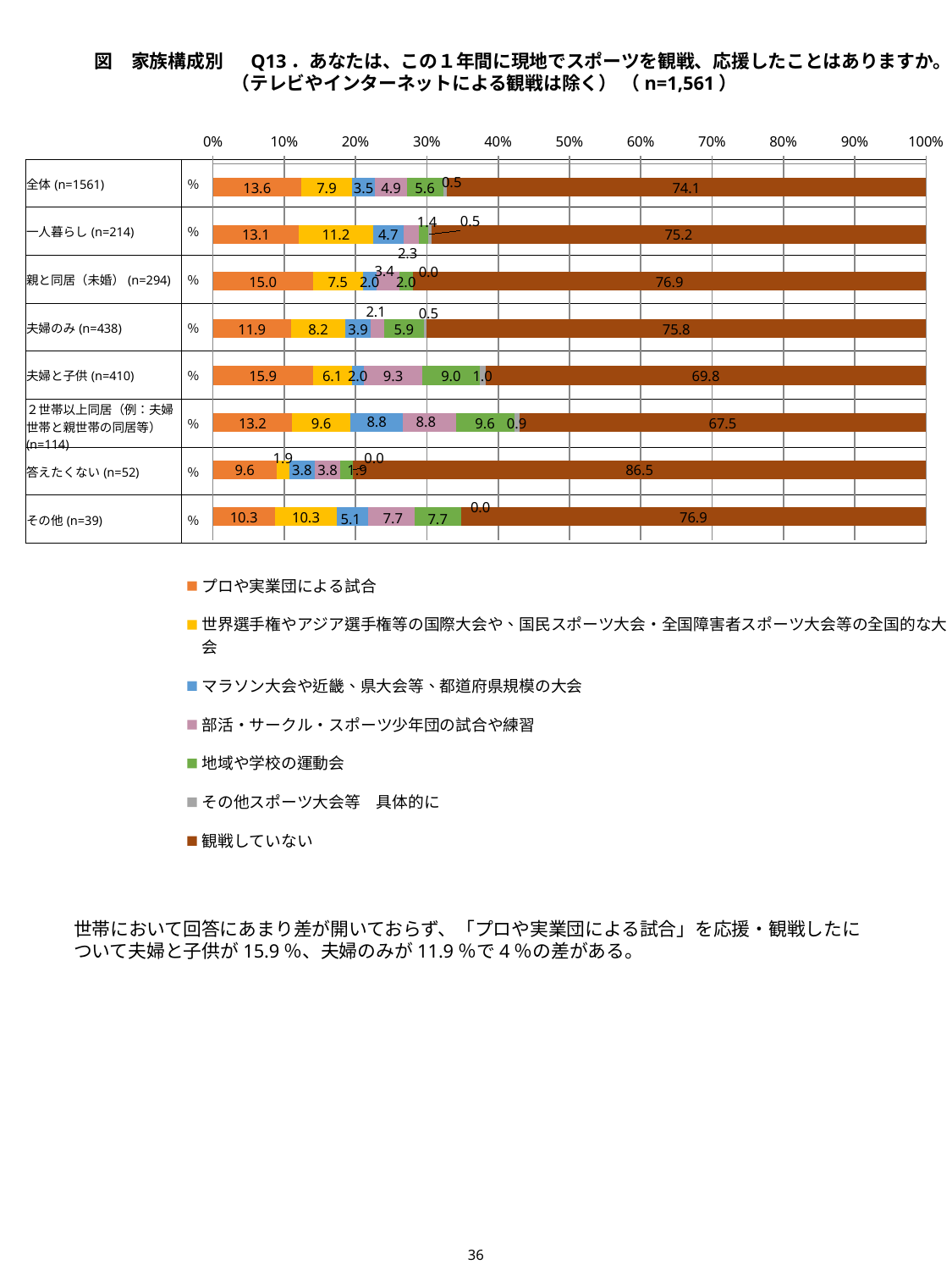
What is the value for 世界選手権やアジア選手権等の国際大会や、国民スポーツ大会・全国障害者スポーツ大会等の全国的な大会 in the 一人暮らし (n=214) row? 11.2 Which is larger: the 部活・サークル・スポーツ少年団の試合や練習 value for 夫婦と子供 (n=410) or for 全体 (n=1561)? 夫婦と子供 (n=410) Which category has the highest value for 観戦していない? 答えたくない (n=52) Which category has the highest value for プロや実業団による試合? 夫婦と子供 (n=410) Which category has the lowest value for 観戦していない? ２世帯以上同居（例：夫婦世帯と親世帯の同居等）(n=114) What is the value for 観戦していない in the 全体 (n=1561) row? 74.1 How many series does the legend list? 7 What kind of chart is shown on the slide? Stacked bar chart What is the value for プロや実業団による試合 in the 夫婦と子供 (n=410) row? 15.9 How many family-composition categories are plotted in the chart? 8 What is the difference between the プロや実業団による試合 values for 夫婦と子供 (n=410) and 夫婦のみ (n=438)? 4.0 What is the value for 地域や学校の運動会 in the ２世帯以上同居 (n=114) row? 9.6